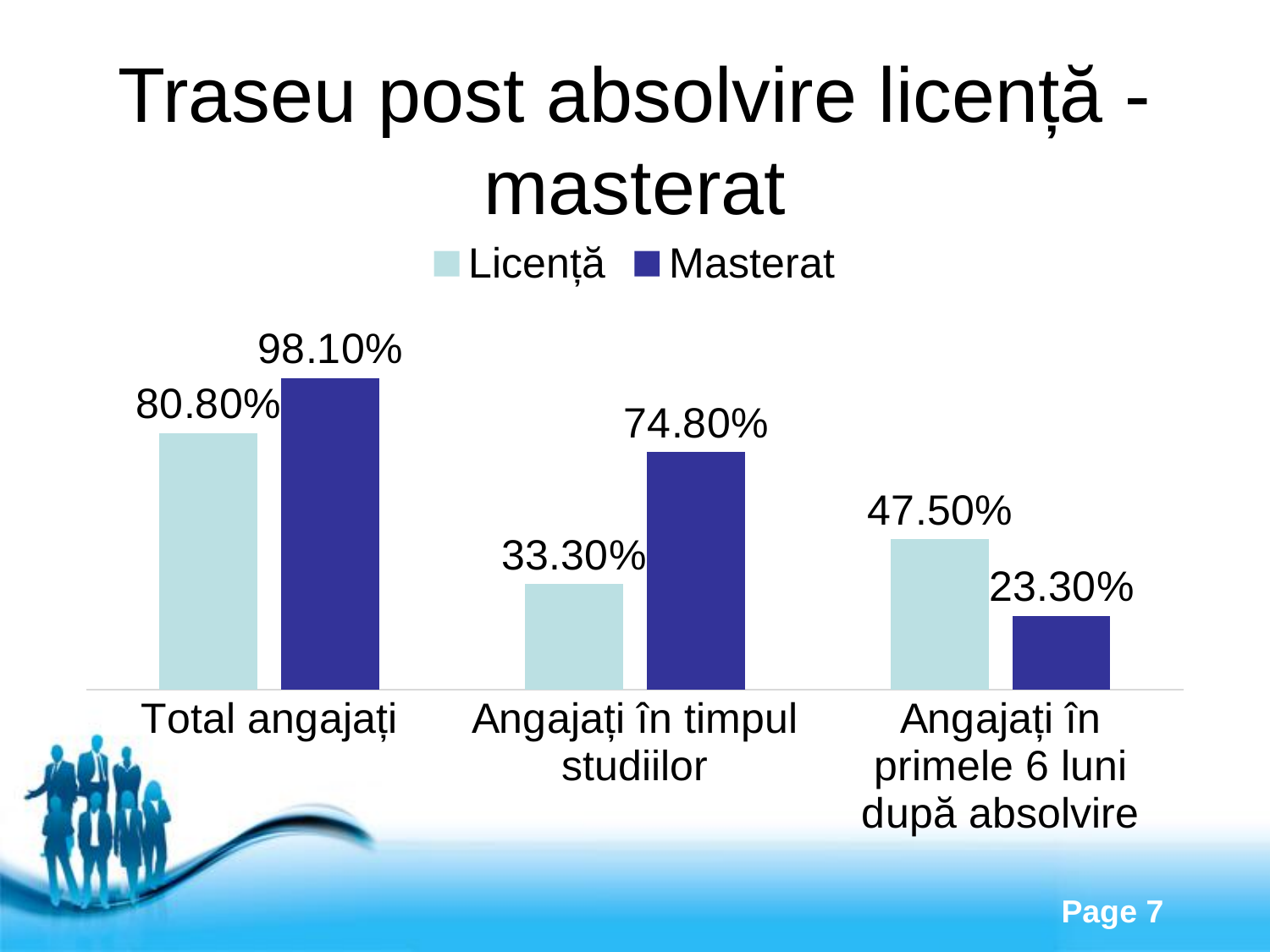
What are the two series named in the legend? Licență and Masterat What is the difference between the Licență and Masterat values for Angajați în timpul studiilor? 41.50% Which category has the lowest Licență value? Angajați în timpul studiilor What is the Masterat value for Angajați în timpul studiilor? 74.80% For Angajați în primele 6 luni după absolvire, which series has the larger value, Licență or Masterat? Licență How many series does the legend list? 2 What is the Licență value for Total angajați? 80.80% What kind of chart is shown on the slide? Bar chart What is the difference between the Masterat and Licență values for Total angajați? 17.30% How many categories are shown on the x axis? 3 What is the Masterat value for Angajați în primele 6 luni după absolvire? 23.30% Which category has the highest Masterat value? Total angajați